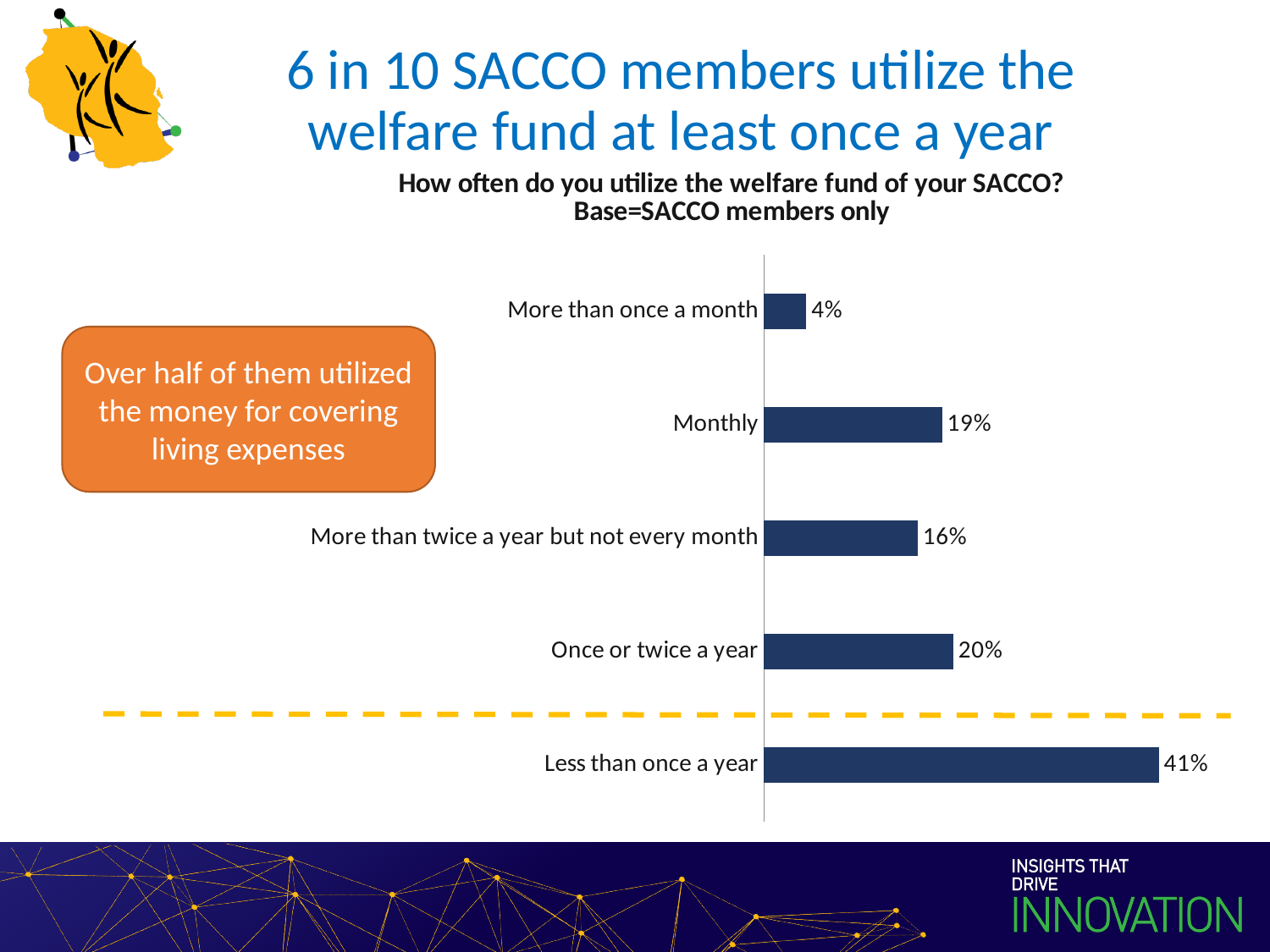
What percentage of SACCO members utilize the welfare fund monthly? 19% What is the difference between the values for 'Monthly' and 'More than once a month'? 15% Which is larger, the value for 'Monthly' or the value for 'More than twice a year but not every month'? Monthly What kind of chart is shown on the slide? Bar chart What is the difference between the values for 'Less than once a year' and 'Once or twice a year'? 21% What question is the chart based on, as stated in the chart title? How often do you utilize the welfare fund of your SACCO? What percentage of SACCO members utilize the welfare fund less than once a year? 41% What is the value for 'More than twice a year but not every month'? 16% What is the value for 'Once or twice a year'? 20% Which category has the highest value? Less than once a year Which category has the lowest value? More than once a month How many categories are shown in the chart? 5